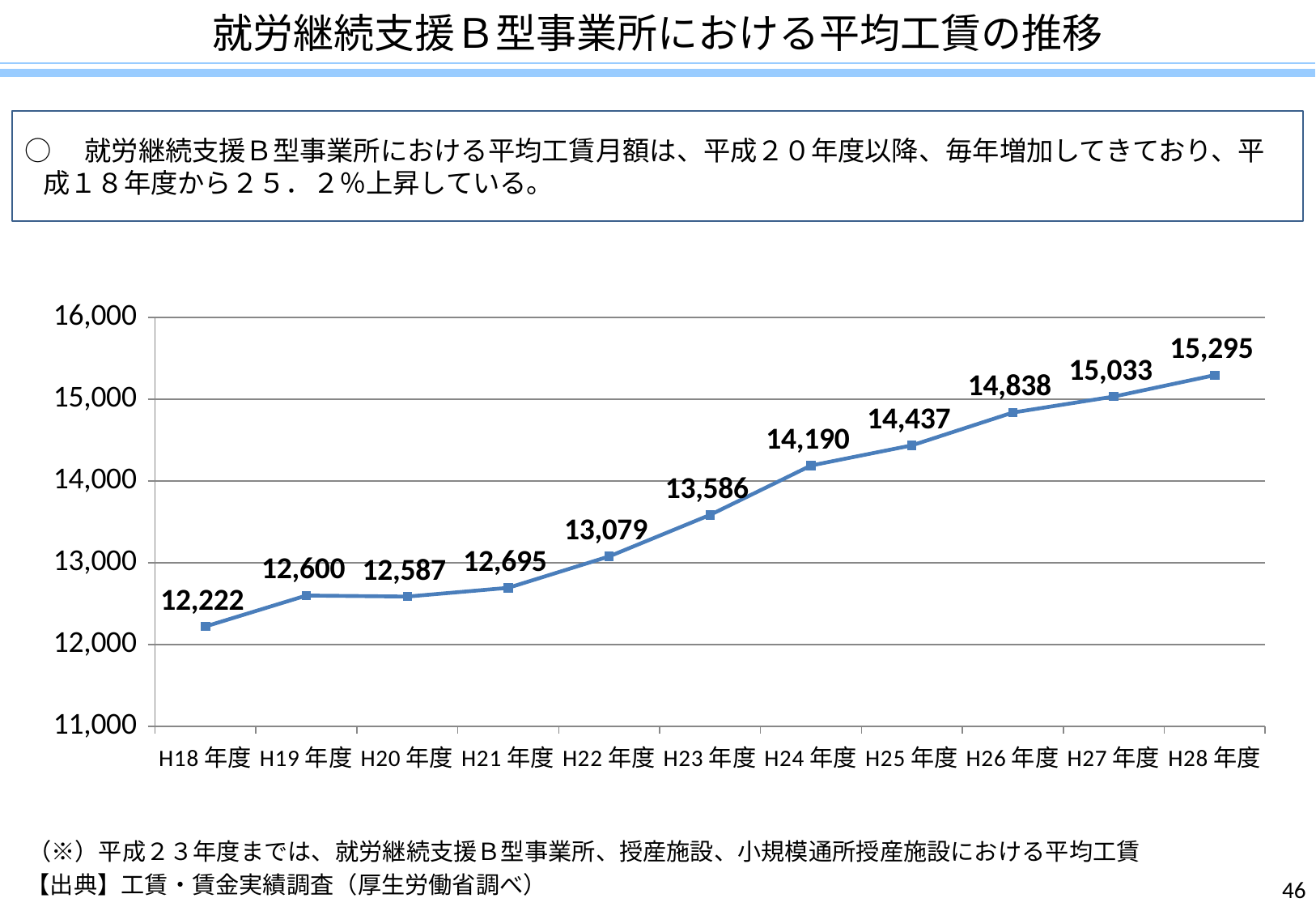
Which year has the highest value? H28年度 What is the difference between the values for H24年度 and H23年度? 604 Do the values generally rise or fall from H18年度 to H28年度? rise Which is larger, the value for H19年度 or the value for H20年度? H19年度 What is the difference between the values for H28年度 and H18年度? 3,073 How many years are plotted on the x axis? 11 What is the value for H18年度? 12,222 Is the value for H26年度 greater or less than 15,000? less Which year has the lowest value? H18年度 What kind of chart is shown? line chart What is the value for H28年度? 15,295 What is the value for H24年度? 14,190